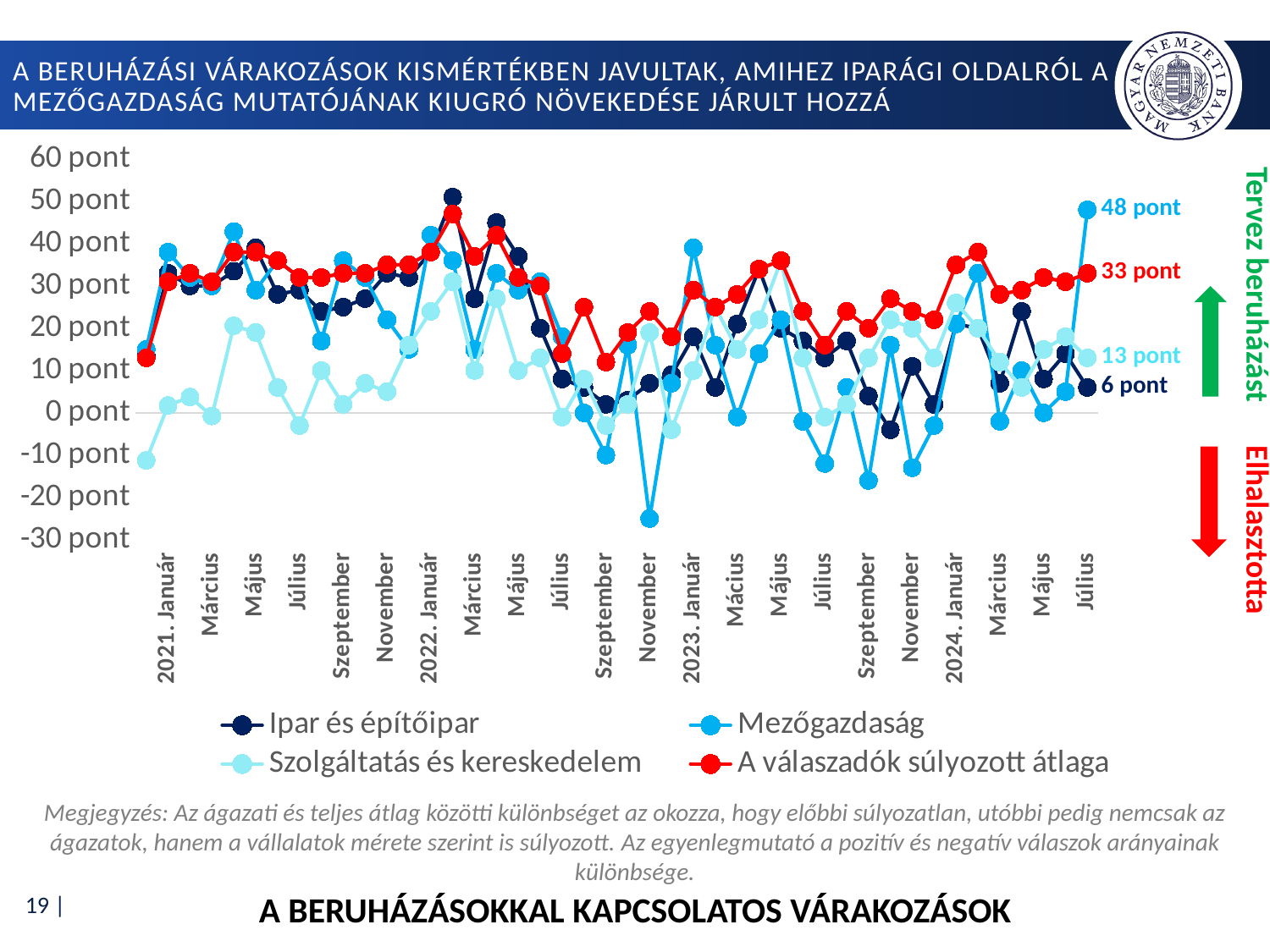
At the last point (Július 2024), which is larger: Szolgáltatás és kereskedelem or Ipar és építőipar? Szolgáltatás és kereskedelem How many series does the legend list? 4 Is the value of the Mezőgazdaság series in November 2022 greater or less than -10 pont? less What is the value of the Ipar és építőipar series at the last point (Július 2024)? 6 pont Which series has the lowest value at the last point (Július 2024)? Ipar és építőipar What is the value of the Szolgáltatás és kereskedelem series at the last point (Július 2024)? 13 pont What is the value of the Mezőgazdaság series at the last point (Július 2024)? 48 pont At the last point (Július 2024), how much higher is Mezőgazdaság than A válaszadók súlyozott átlaga? 15 pont What kind of chart is shown on the slide? line chart What is the title of the chart shown at the bottom of the slide? A BERUHÁZÁSOKKAL KAPCSOLATOS VÁRAKOZÁSOK Which series has the highest value at the last point (Július 2024)? Mezőgazdaság What is the value of A válaszadók súlyozott átlaga at the last point (Július 2024)? 33 pont